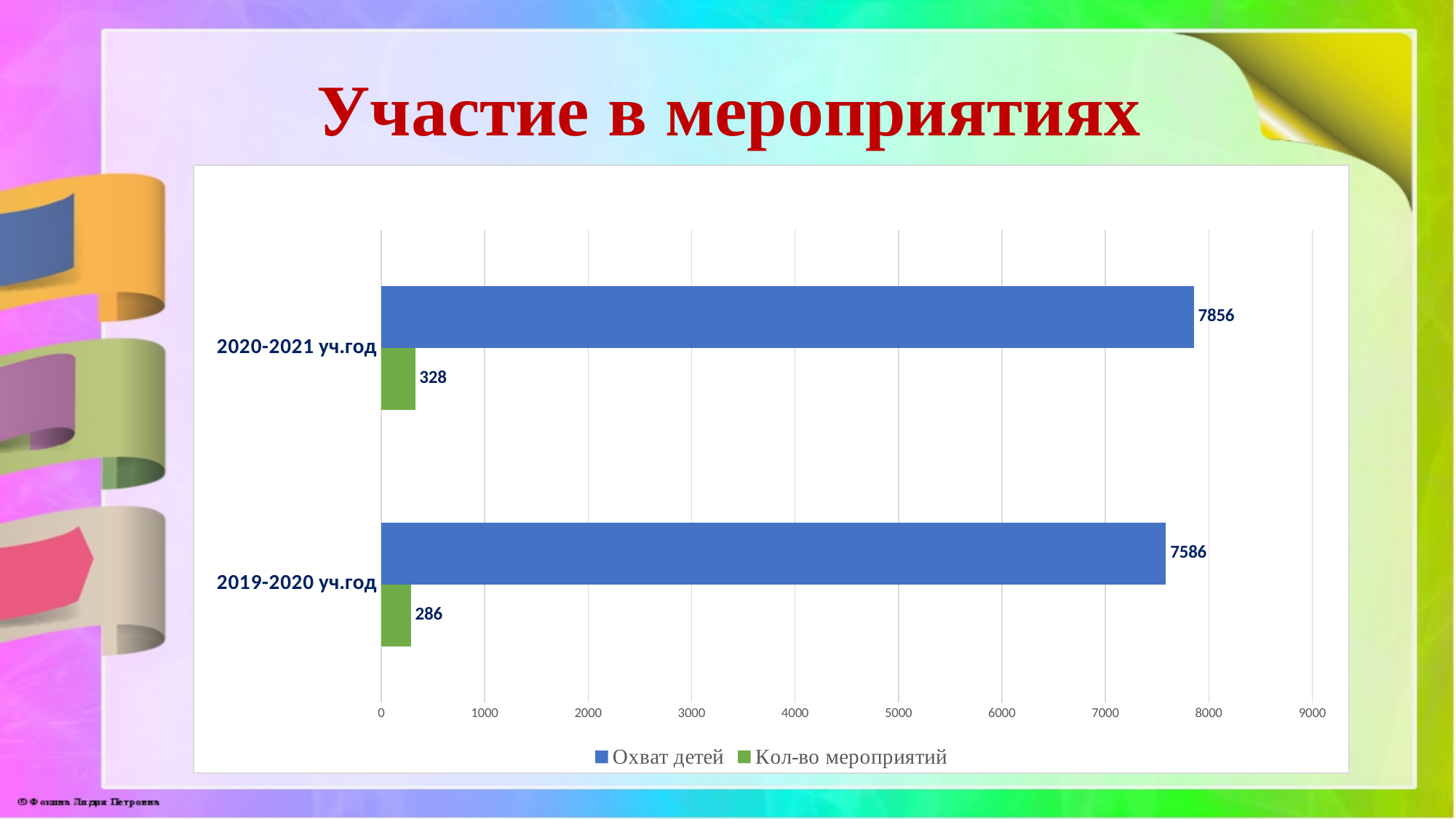
Which year has the higher value for Охват детей? 2020-2021 уч.год Is the value of Охват детей for 2019-2020 уч.год greater or less than 8000? less What is the value of Кол-во мероприятий for 2020-2021 уч.год? 328 What is the difference in Охват детей between 2020-2021 уч.год and 2019-2020 уч.год? 270 How many categories (academic years) are shown on the chart? 2 What is the difference in Кол-во мероприятий between 2020-2021 уч.год and 2019-2020 уч.год? 42 What type of chart is shown on the slide? bar chart How many series does the legend list? 2 What is the value of Охват детей for 2020-2021 уч.год? 7856 Which year has the lower value for Кол-во мероприятий? 2019-2020 уч.год What is the value of Кол-во мероприятий for 2019-2020 уч.год? 286 What is the value of Охват детей for 2019-2020 уч.год? 7586